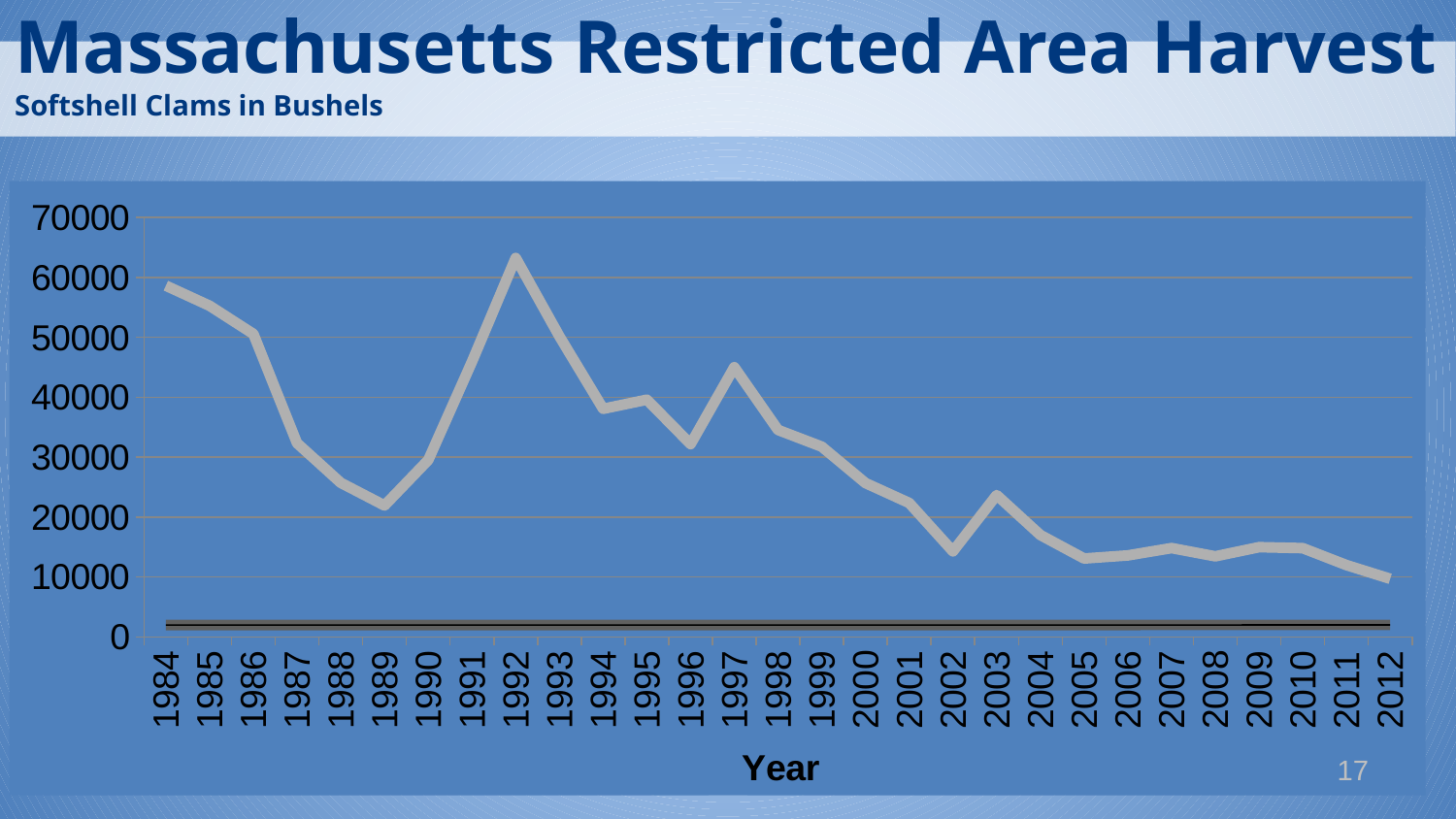
What kind of chart is shown on the slide? line chart What is the label on the x axis? Year Is the value for 2012 greater or less than 20000? less Which year has the larger harvest, 1984 or 1992? 1992 Is the value for 1984 greater or less than 50000? greater How many years are plotted along the x axis? 29 Is the value for 1989 greater or less than 30000? less Overall, do the harvest values rise or fall from 1984 to 2012? fall In which year is the harvest at its lowest? 2012 In which year does the harvest reach its highest value? 1992